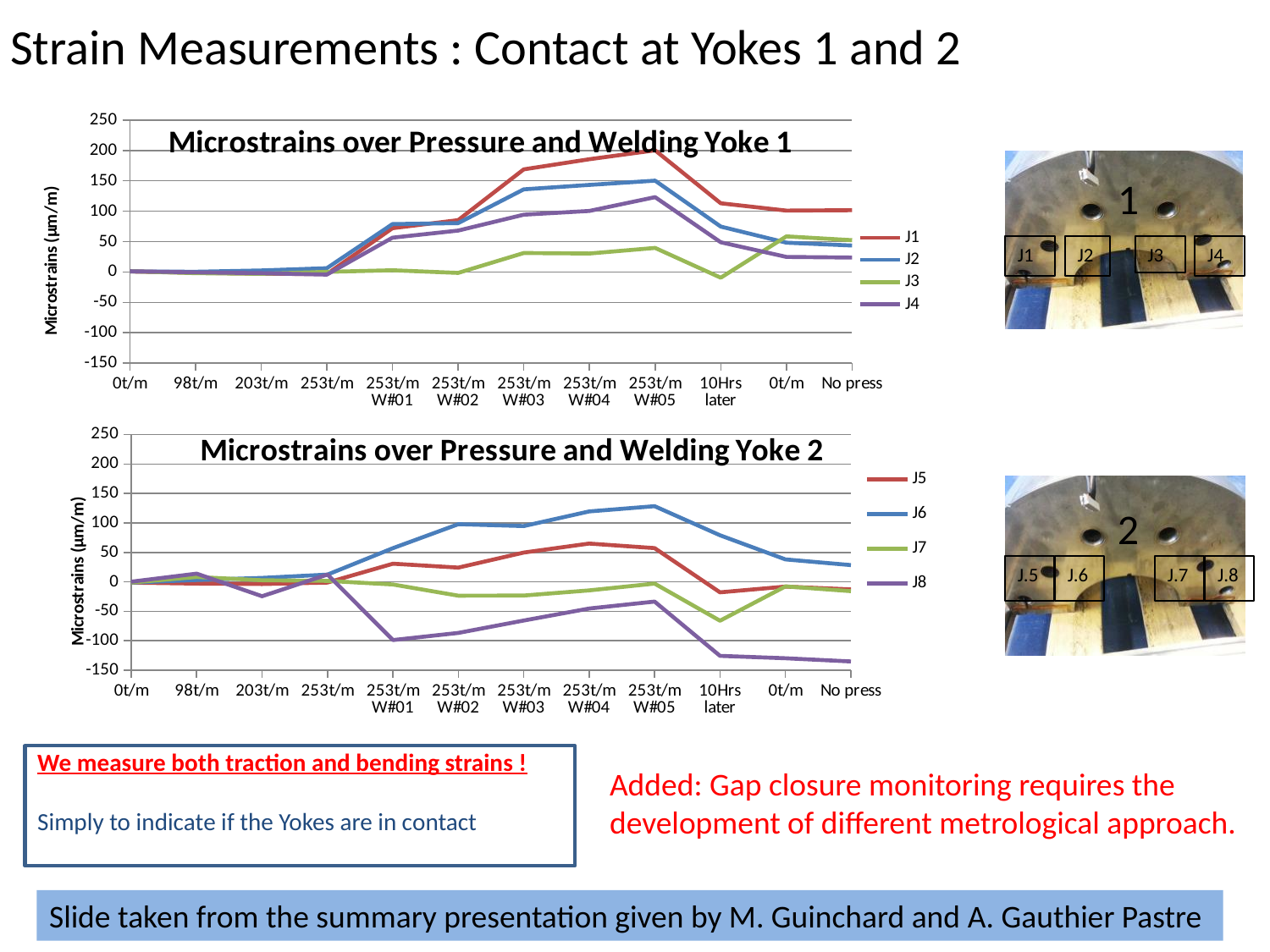
What type of chart is the top chart titled "Microstrains over Pressure and Welding Yoke 1"? Line chart In the "Microstrains over Pressure and Welding Yoke 1" chart, at 253t/m W#05, which is larger, J1 or J3? J1 How many series does the legend of the "Microstrains over Pressure and Welding Yoke 2" chart list? 4 How many categories are shown on the x axis of the "Microstrains over Pressure and Welding Yoke 1" chart? 12 In the "Microstrains over Pressure and Welding Yoke 1" chart, which series reaches the highest value? J1 In the "Microstrains over Pressure and Welding Yoke 2" chart, is the value of J7 at 10Hrs later greater or less than -50? less In the "Microstrains over Pressure and Welding Yoke 2" chart, does J8 rise or fall between 253t/m and 253t/m W#01? fall In the "Microstrains over Pressure and Welding Yoke 2" chart, is the value of J8 at No press greater or less than -100? less In the "Microstrains over Pressure and Welding Yoke 2" chart, which series reaches the lowest value? J8 What is the y-axis label of the "Microstrains over Pressure and Welding Yoke 1" chart? Microstrains (µm/m) In the "Microstrains over Pressure and Welding Yoke 2" chart, which series reaches the highest value? J6 In the "Microstrains over Pressure and Welding Yoke 1" chart, is the value of J1 at 253t/m W#03 greater or less than 150? greater